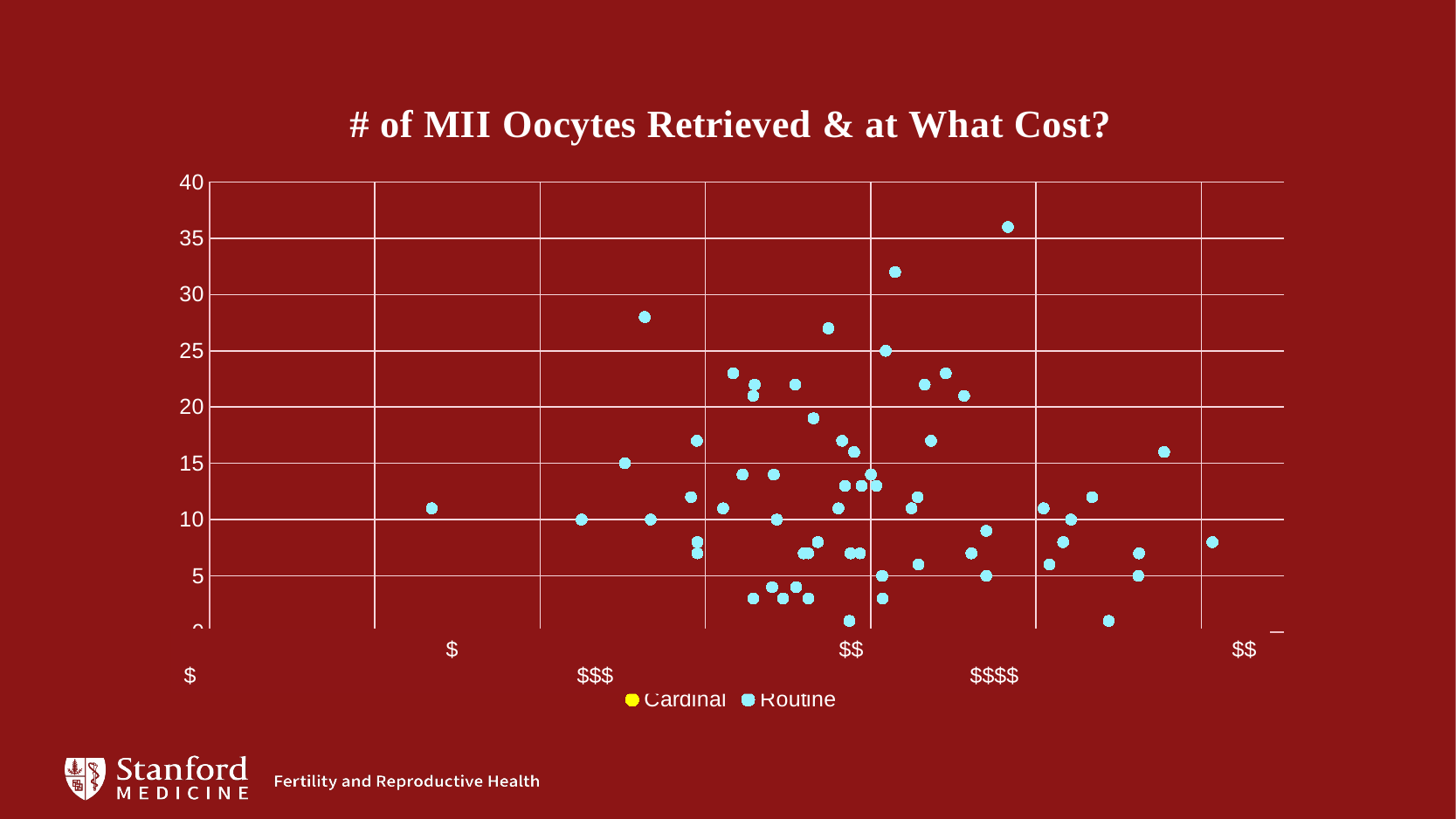
Is the highest plotted point on the chart greater or less than 30? greater What is the title of the chart? # of MII Oocytes Retrieved & at What Cost? Is the highest plotted point on the chart greater or less than 35? greater What are the two series named in the legend? Cardinal and Routine Is the lowest plotted point on the chart greater or less than 10? less How many series does the legend list? 2 What kind of chart is shown on the slide? scatter chart